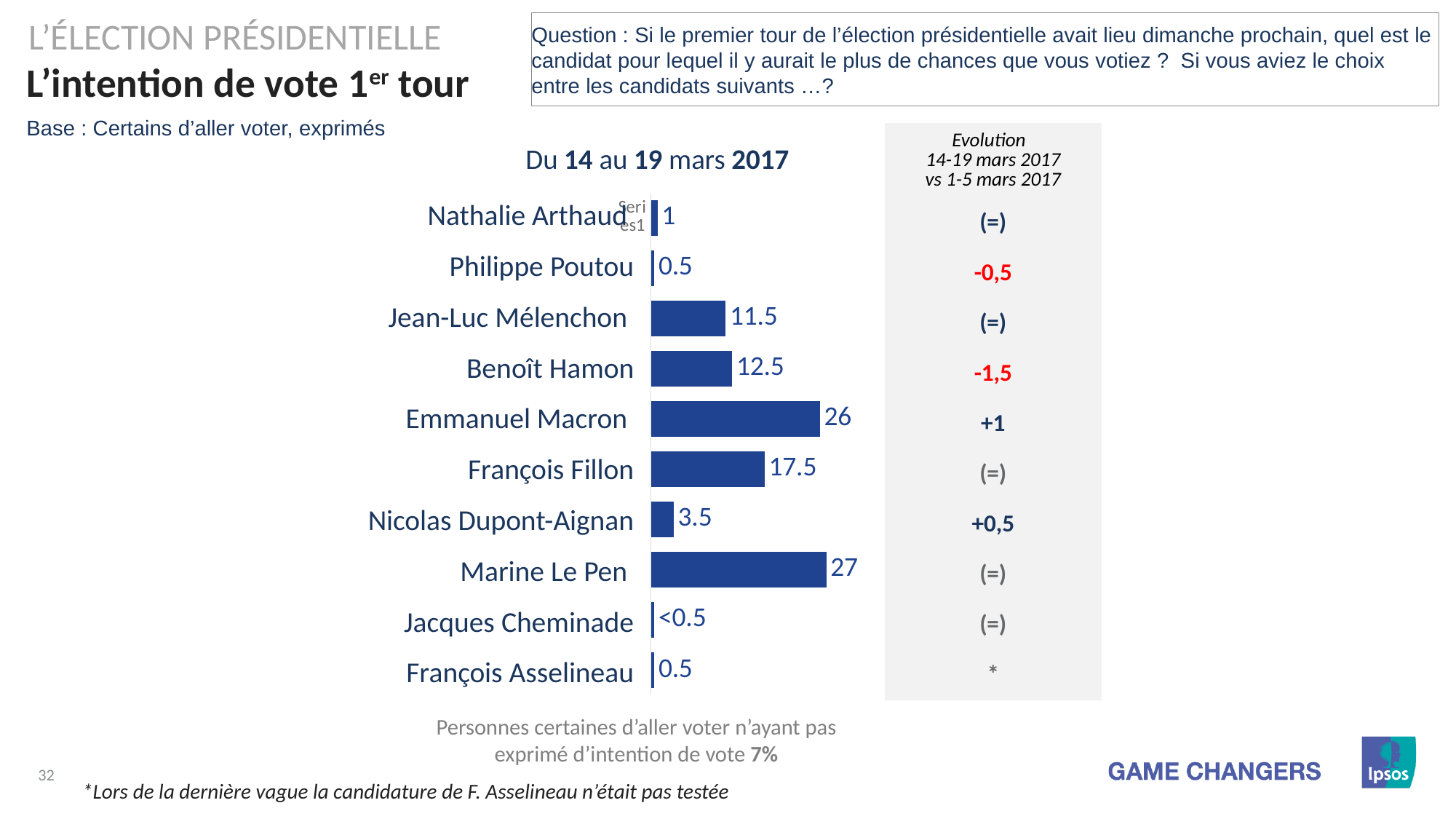
What is the value for Nicolas Dupont-Aignan? 3.5 What period does the chart title say the data covers? Du 14 au 19 mars 2017 What is the value shown for Jacques Cheminade? <0.5 What is the difference between the values for Marine Le Pen and Emmanuel Macron? 1 What is the value for Emmanuel Macron? 26 What is the evolution shown for Benoît Hamon versus 1-5 mars 2017? -1,5 How many candidates are shown in the chart? 10 What is the value for Jean-Luc Mélenchon? 11.5 Which candidate has the highest value? Marine Le Pen Which is larger, the value for Benoît Hamon or the value for Jean-Luc Mélenchon? Benoît Hamon What kind of chart is shown? Bar chart What is the difference between the values for François Fillon and Benoît Hamon? 5